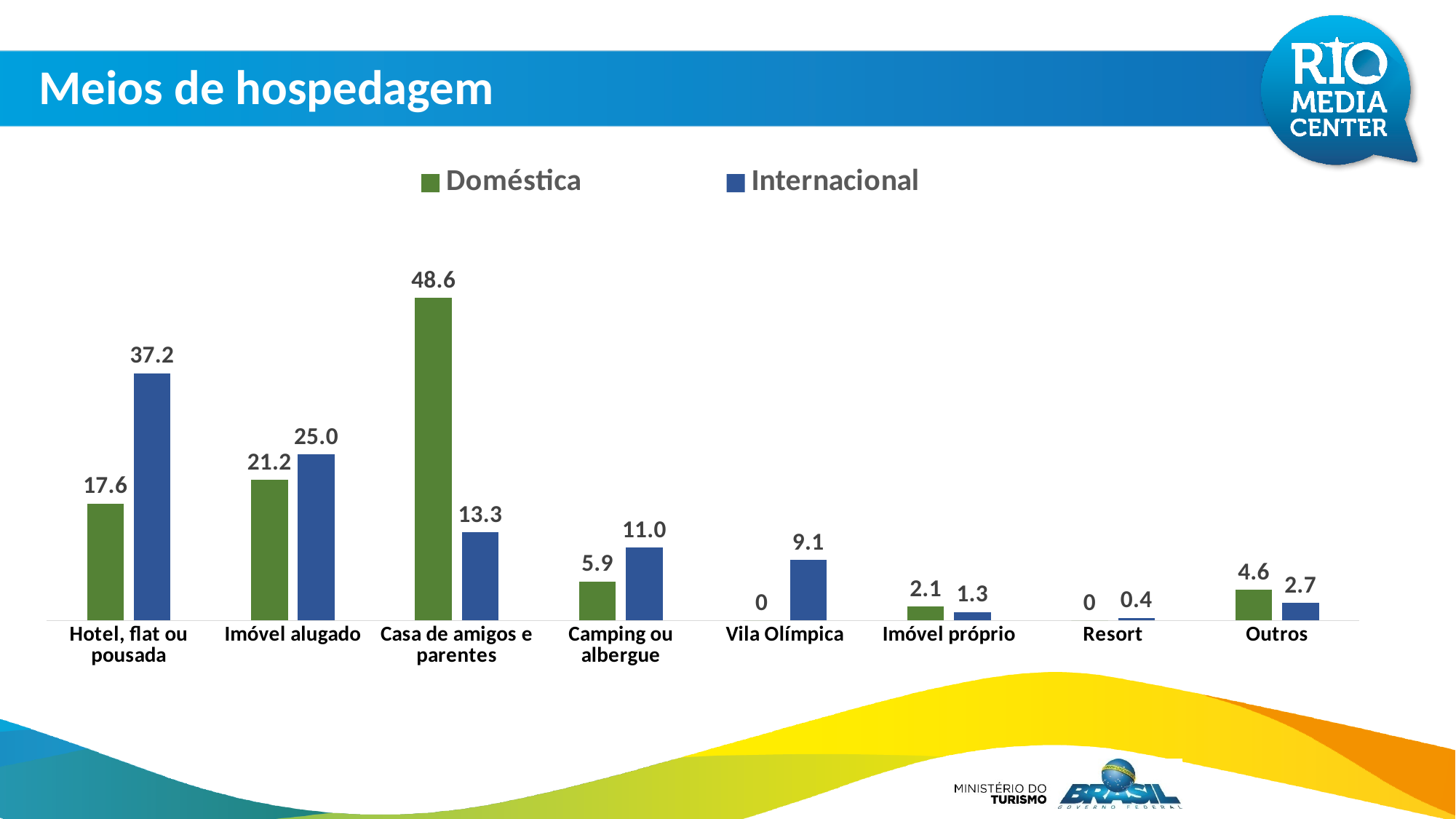
Which is larger for Imóvel alugado, the Doméstica or the Internacional value? Internacional What is the Internacional value for Hotel, flat ou pousada? 37.2 What is the Doméstica value for Resort? 0 What is the Doméstica value for Casa de amigos e parentes? 48.6 Which category has the lowest Internacional value? Resort What is the difference between the Internacional and Doméstica values for Hotel, flat ou pousada? 19.6 What is the Internacional value for Vila Olímpica? 9.1 How many categories are shown on the x axis? 8 Which category has the highest Doméstica value? Casa de amigos e parentes How many series does the legend list? 2 What is the title of the slide? Meios de hospedagem What kind of chart is shown on the slide? Bar chart